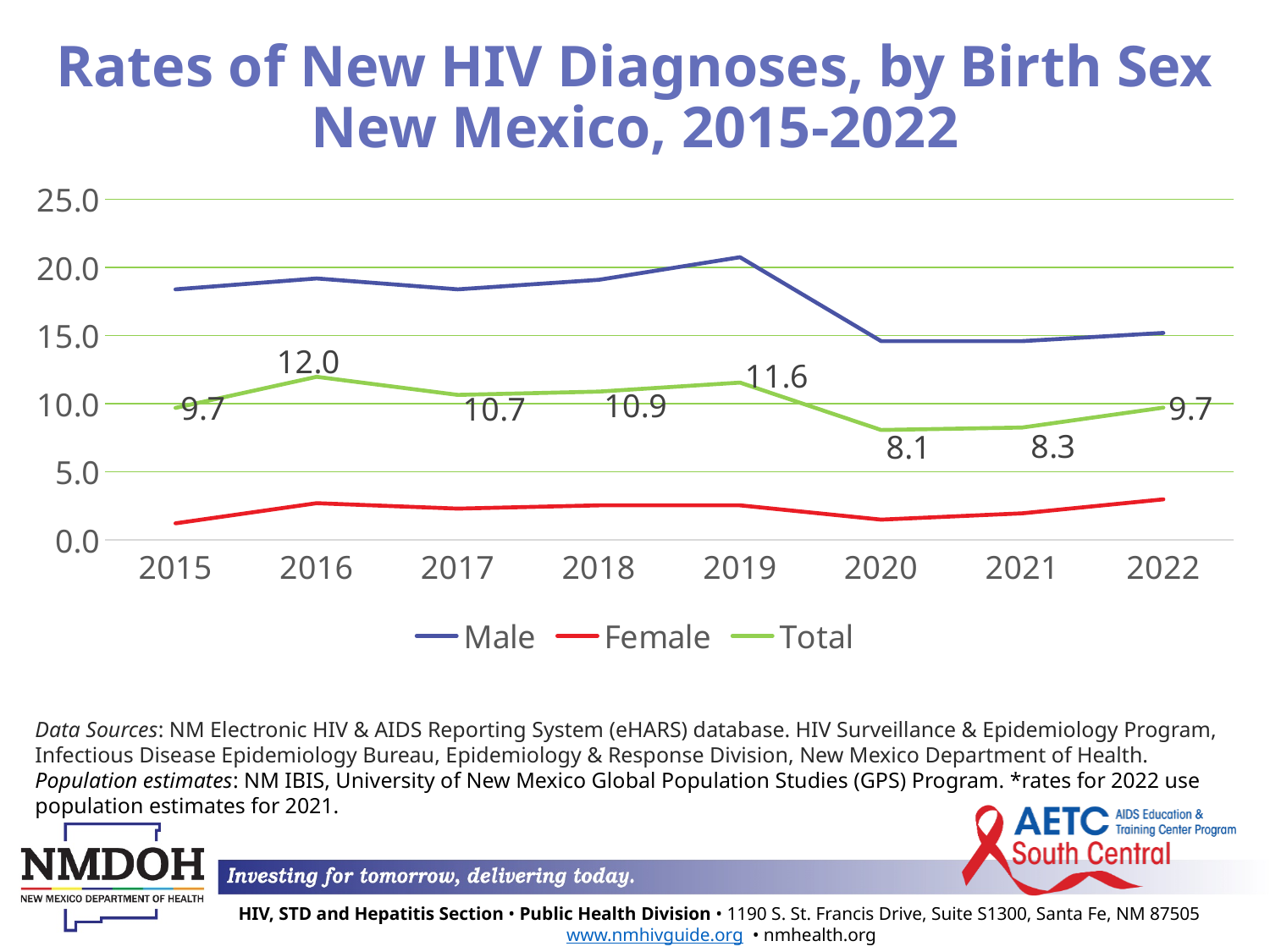
What is the Total rate of new HIV diagnoses in 2016? 12.0 Is the Male rate in 2019 greater or less than 20.0? greater How many years are plotted along the x axis? 8 In which year is the Total rate lowest? 2020 Which year has the larger Total rate, 2017 or 2018? 2018 In which year is the Total rate highest? 2016 What kind of chart is shown on the slide? Line chart What is the Total rate of new HIV diagnoses in 2020? 8.1 What is the difference between the Total rate in 2016 and the Total rate in 2020? 3.9 Does the Total rate rise or fall from 2019 to 2020? Fall Is the Female rate in 2016 greater or less than 5.0? less How many series does the legend list? 3